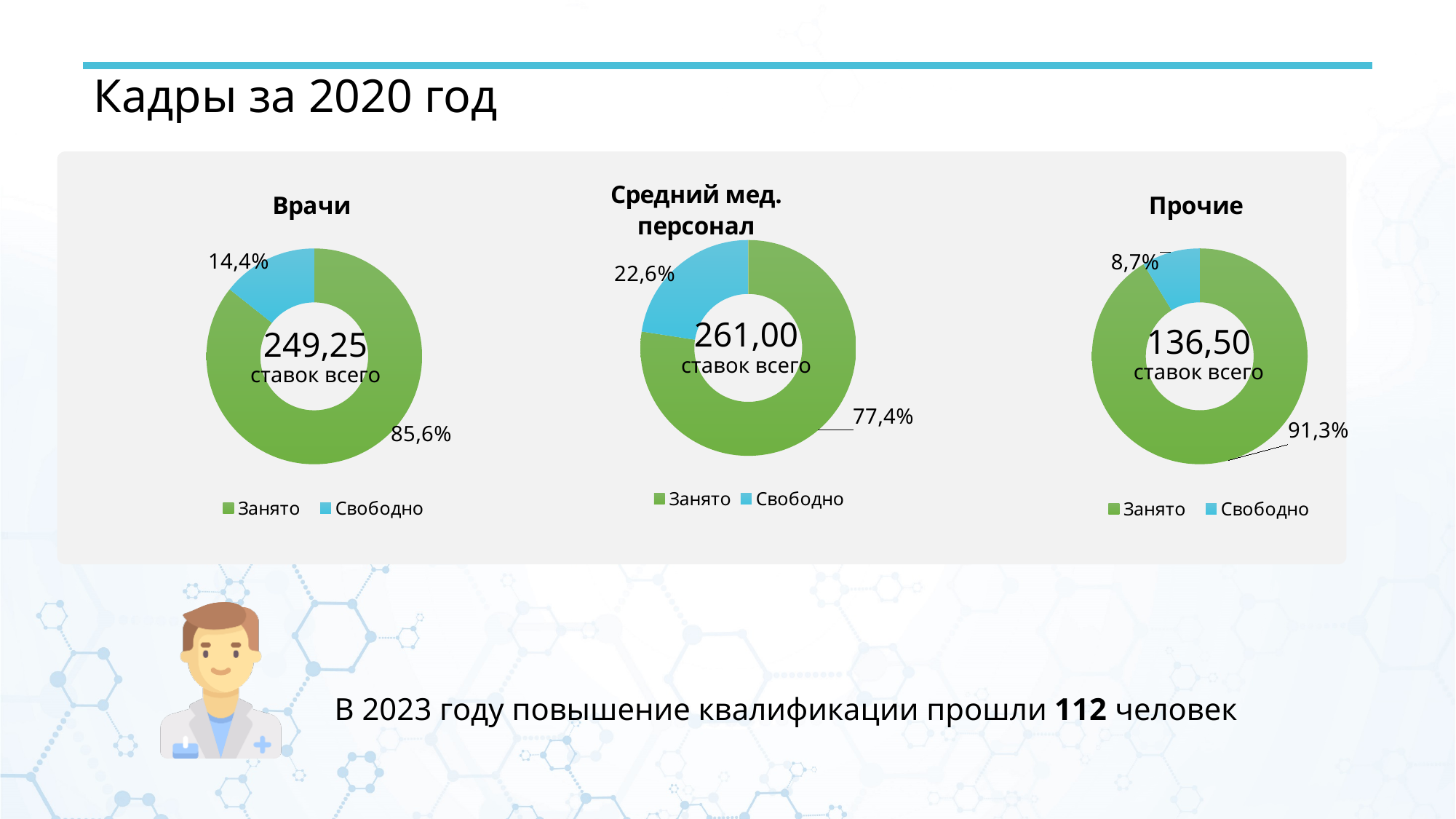
In the 'Средний мед. персонал' chart, what total number of 'ставок всего' is shown in the centre? 261,00 What type of chart is used for 'Прочие'? Doughnut (pie) chart In the 'Средний мед. персонал' chart, what share is labelled 'Занято'? 77,4% Which chart has the largest 'Свободно' share: 'Врачи', 'Средний мед. персонал' or 'Прочие'? Средний мед. персонал In the 'Врачи' chart, what total number of 'ставок всего' is shown in the centre? 249,25 In the 'Врачи' chart, what is the difference between the 'Занято' and 'Свободно' shares? 71,2% In the 'Средний мед. персонал' chart, what share is labelled 'Свободно'? 22,6% In the 'Прочие' chart, what total number of 'ставок всего' is shown in the centre? 136,50 In the 'Врачи' chart, what share is labelled 'Занято'? 85,6%